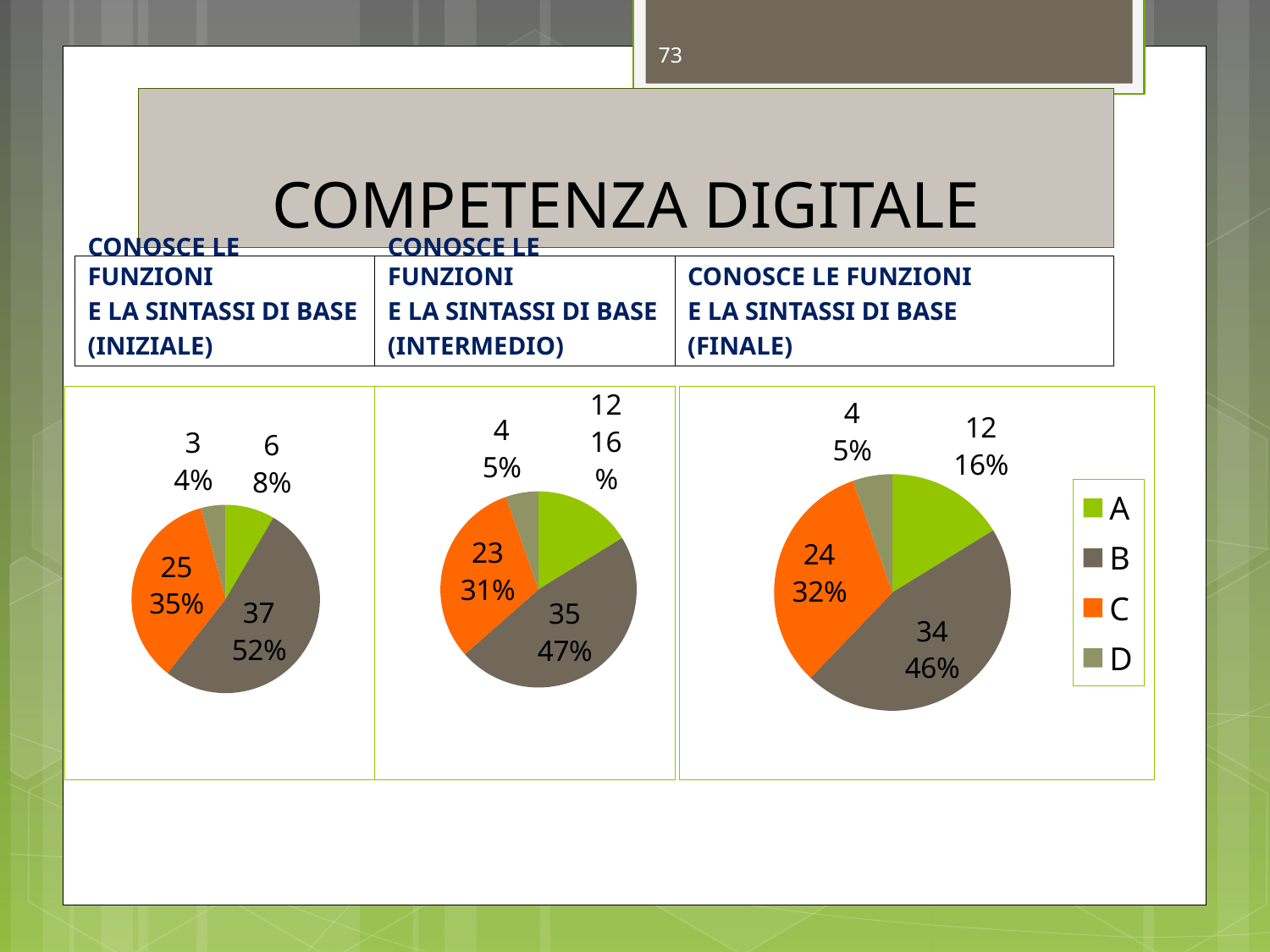
In the INIZIALE pie chart (left), what is the value of slice D? 3 In the INTERMEDIO pie chart (middle), which category has the largest slice? B In the FINALE pie chart (right), which category has the smallest slice? D What is the difference between the value of slice B in the INIZIALE chart (37) and slice B in the FINALE chart (34)? 3 In the INIZIALE pie chart (left), what is the value of the largest slice, B? 37 In the FINALE pie chart (right), what percentage share does slice B (grey) have? 46% In the INIZIALE pie chart (left), what percentage share does slice C (orange) have? 35% How many entries does the legend on the right list? 4 How many slices does the FINALE pie chart (right) have? 4 In the INTERMEDIO pie chart (middle), what is the value of slice A (green)? 12 Is the value of slice C larger in the INIZIALE chart or in the FINALE chart? INIZIALE What type of chart is used for the INIZIALE, INTERMEDIO and FINALE data? Pie chart